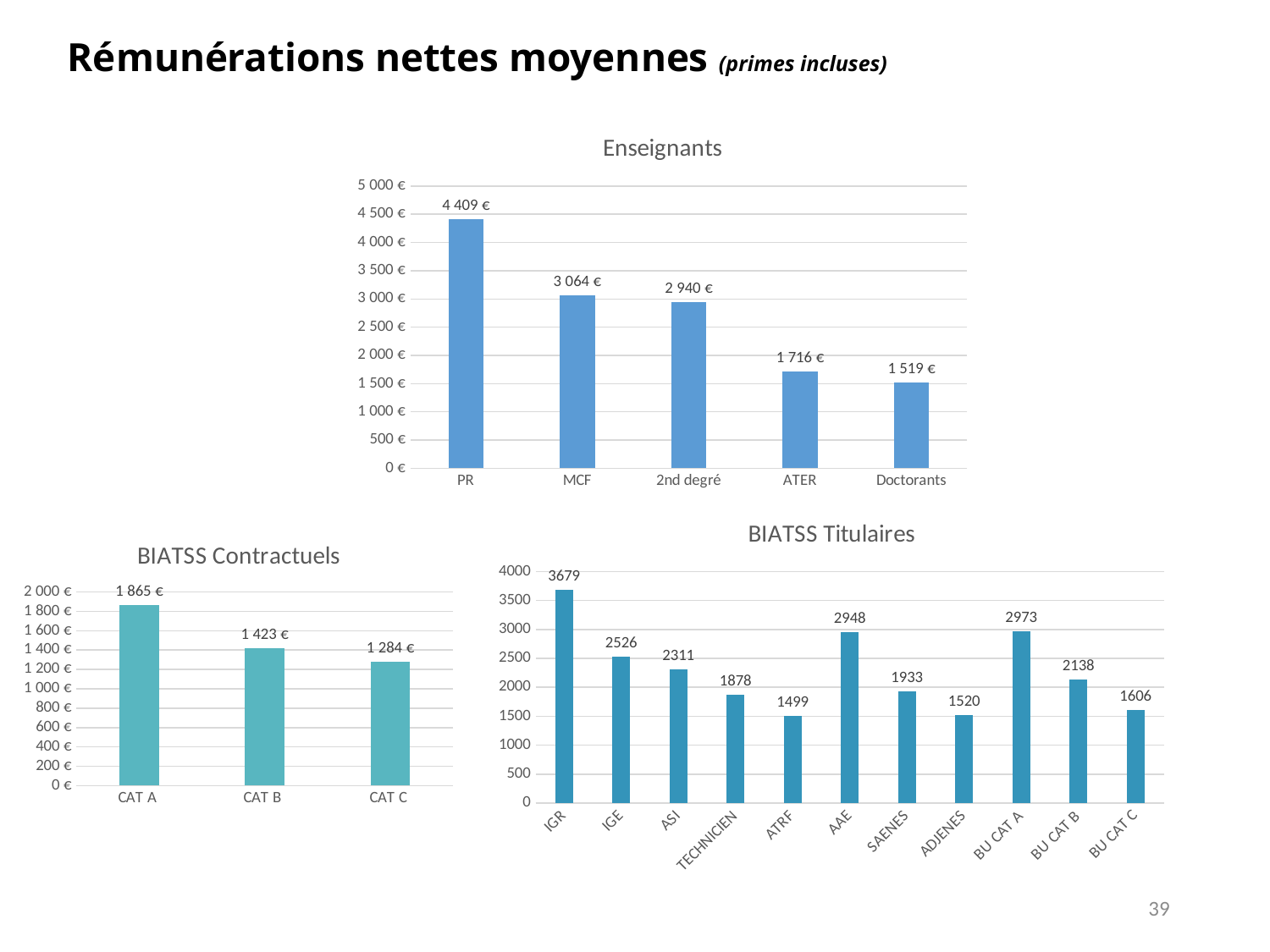
In the BIATSS Contractuels chart, what is the difference between the values for CAT A and CAT C? 581 € In the BIATSS Titulaires chart, which category has the highest value? IGR In the BIATSS Contractuels chart, which category has the lowest value? CAT C In the BIATSS Titulaires chart, how many categories are shown? 11 In the BIATSS Contractuels chart, what is the value for CAT B? 1 423 € In the Enseignants chart, how many categories are shown? 5 In the Enseignants chart, which category has the lowest value? Doctorants In the Enseignants chart, what is the difference between the values for PR and MCF? 1 345 € In the BIATSS Titulaires chart, what is the value for TECHNICIEN? 1878 In the Enseignants chart, which category has the highest value? PR In the Enseignants chart, what is the value for MCF? 3 064 € In the BIATSS Titulaires chart, which is larger, the value for AAE or the value for BU CAT A? BU CAT A